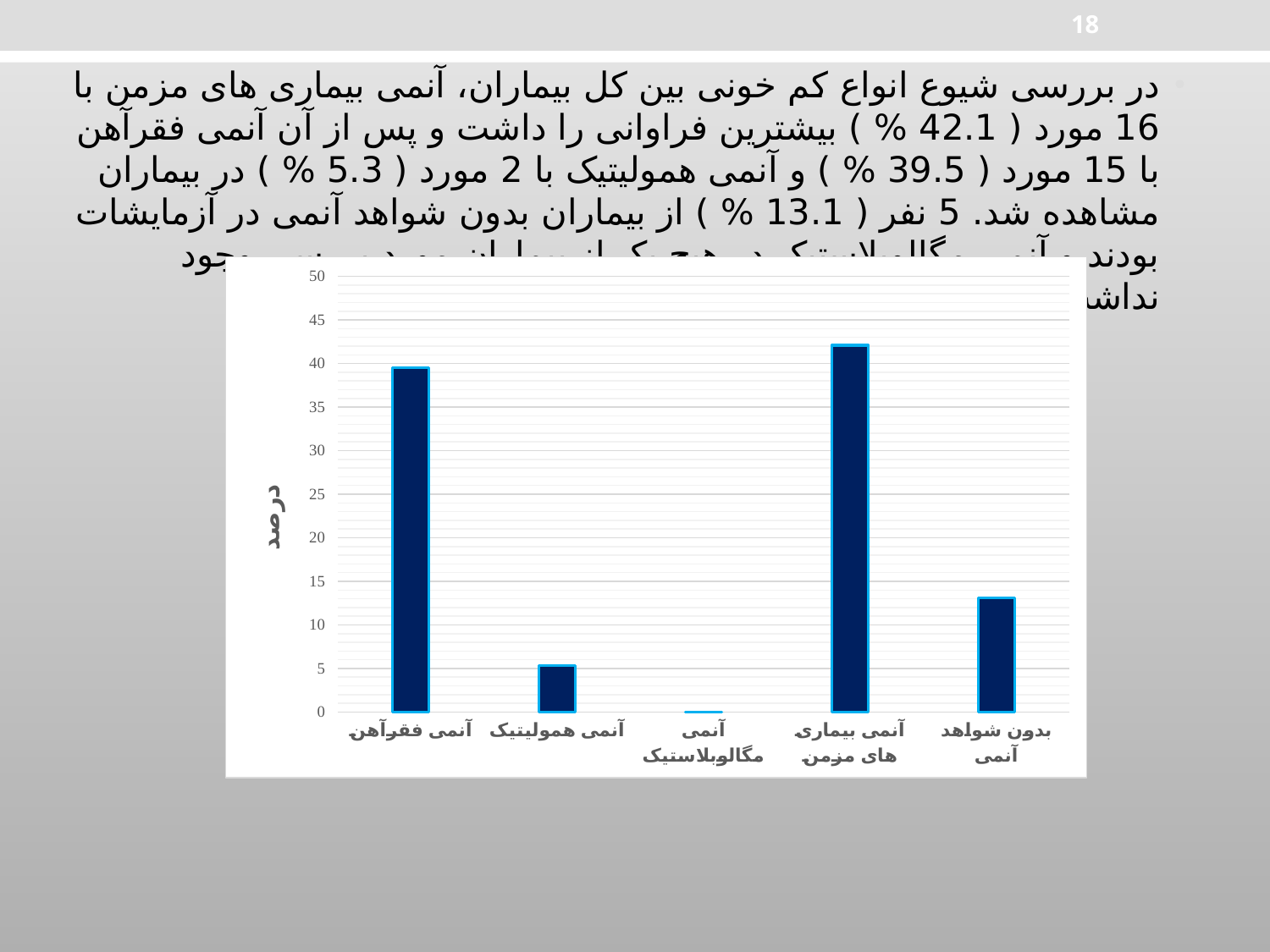
How many categories are shown on the x axis of the chart? 5 Is the value for آنمی همولیتیک greater or less than 10? less What kind of chart is shown on the slide? bar chart What is the label of the vertical axis of the chart? درصد Is the value for آنمی بیماری های مزمن greater or less than 45? less Which category has the highest bar in the chart? آنمی بیماری های مزمن Is the value for آنمی فقرآهن greater or less than 35? greater Which category has the lowest bar in the chart? آنمی مگالوبلاستیک Which is larger, the value for آنمی همولیتیک or the value for بدون شواهد آنمی? بدون شواهد آنمی Which is larger, the value for آنمی فقرآهن or the value for آنمی بیماری های مزمن? آنمی بیماری های مزمن What is the value for آنمی مگالوبلاستیک in the chart? 0